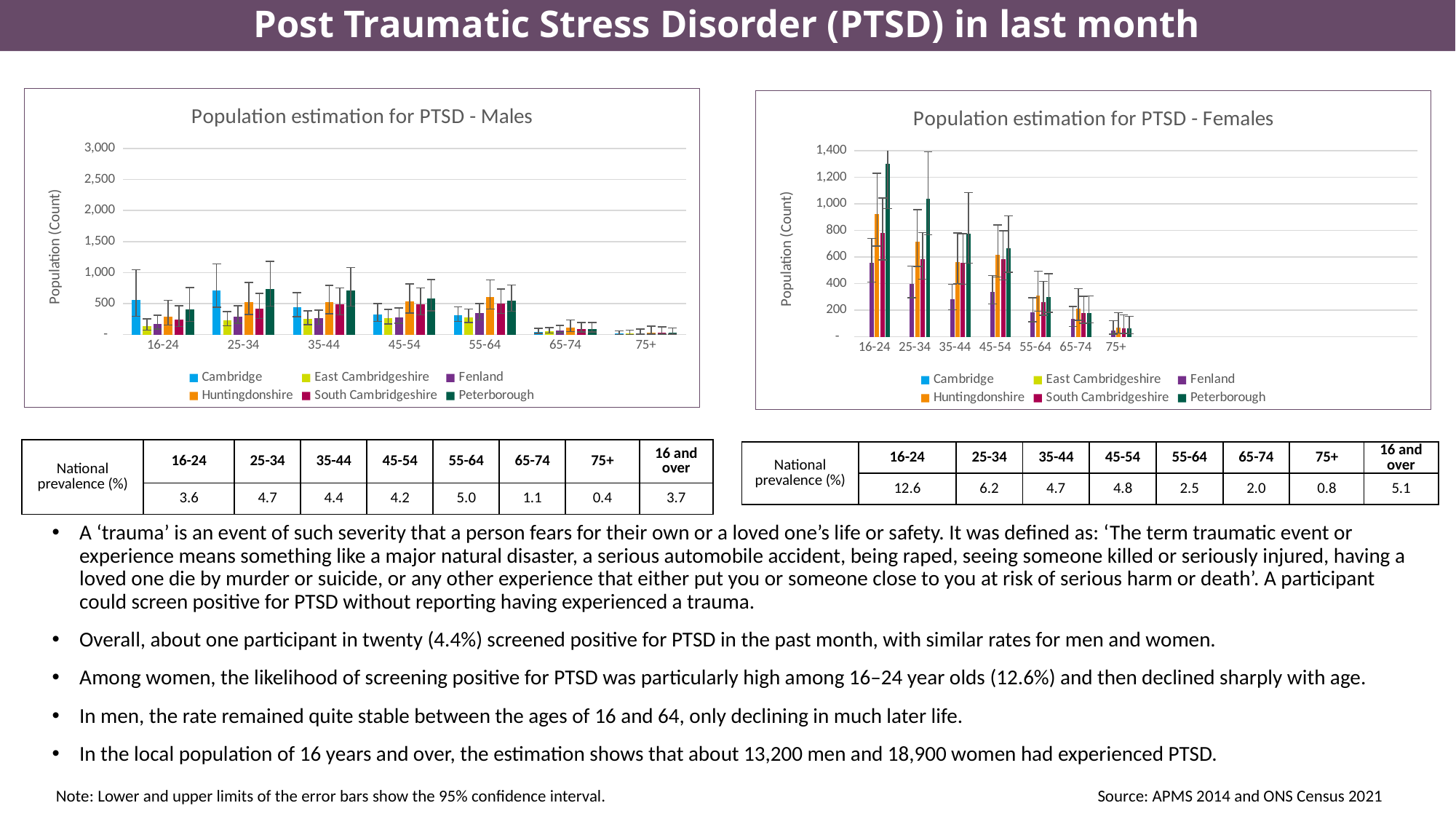
In the 'Population estimation for PTSD - Males' chart, is the Cambridge value for 65-74 greater or less than 500? less How many series does the legend of the 'Population estimation for PTSD - Males' chart list? 6 What is the y-axis label of the 'Population estimation for PTSD - Males' chart? Population (Count) What kind of chart is the 'Population estimation for PTSD - Males' chart? Bar chart In the 'Population estimation for PTSD - Females' chart, is the Peterborough value for 16-24 greater or less than 1,000? greater How many age groups are shown on the x axis of the 'Population estimation for PTSD - Females' chart? 7 In the 'Population estimation for PTSD - Females' chart, which age group has the highest Peterborough bar? 16-24 In the 'Population estimation for PTSD - Males' chart, is the Cambridge value for 25-34 greater or less than 500? greater In the 'Population estimation for PTSD - Females' chart, which is larger for 16-24: Peterborough or Huntingdonshire? Peterborough In the 'Population estimation for PTSD - Males' chart, which age group has the lowest bars overall? 75+ In the 'Population estimation for PTSD - Females' chart, do the Peterborough values rise or fall from 16-24 to 75+? Fall